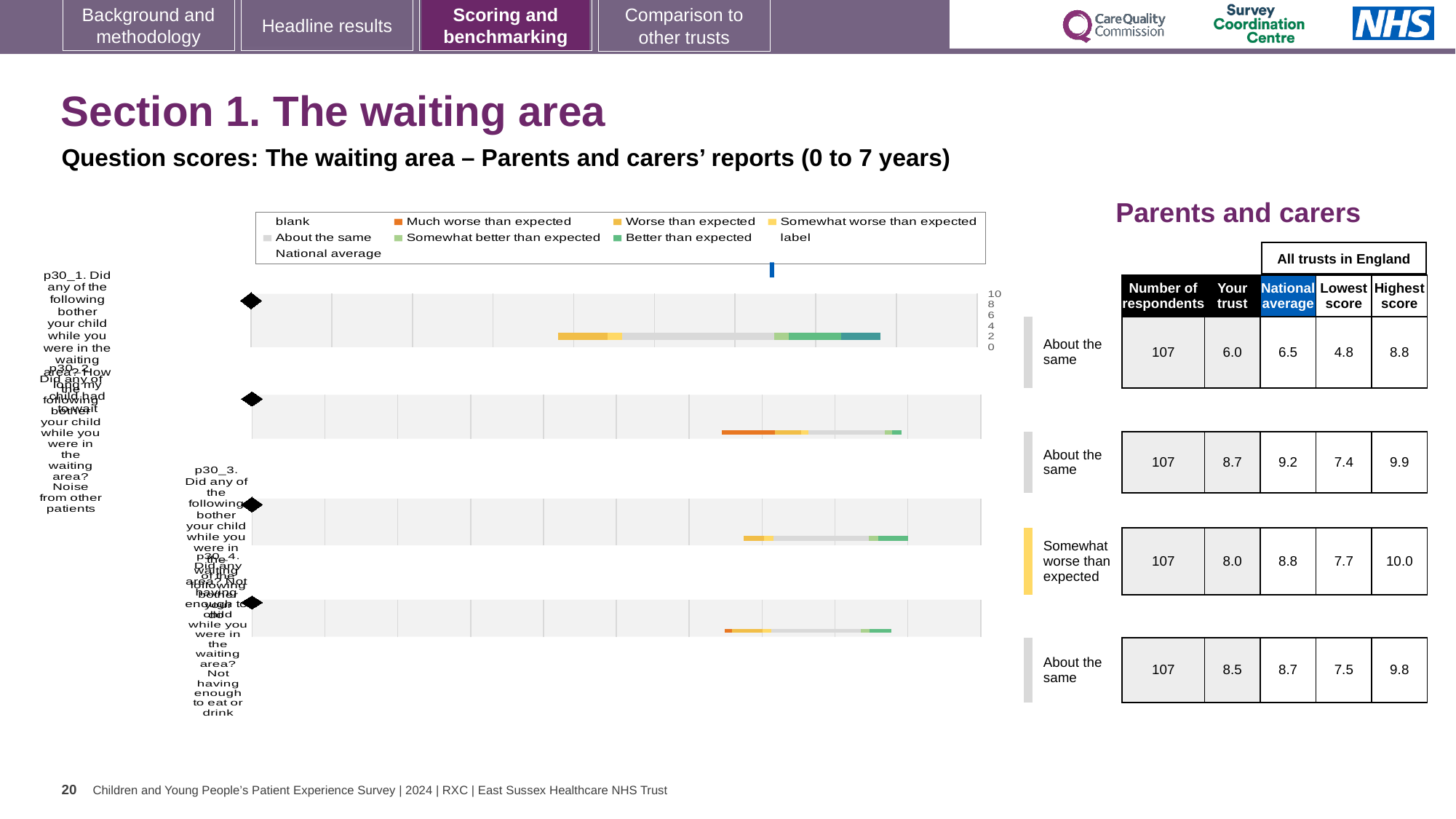
How many entries does the chart legend list? 9 What is the difference between the national average and the 'Your trust' score for the first question (p30_1)? 0.5 In the table beside the chart, what is the national average for the second question (p30_2)? 9.2 In the table beside the chart, what is the highest score across all trusts in England for the third question (p30_3)? 10.0 For the fourth question (p30_4), is the 'Your trust' score or the national average larger? National average (8.7) What kind of chart is shown on the slide? bar chart Which legend entry is shown in orange? Much worse than expected Which benchmark category is assigned to the third question (p30_3)? Somewhat worse than expected How many question bars (p30_1 to p30_4) are plotted in the chart? 4 In the table beside the chart, which question has the highest 'Your trust' score? p30_2 (second row), 8.7 In the table beside the chart, which question has the lowest 'Your trust' score? p30_1 (first row), 6.0 In the table beside the chart, what is the 'Your trust' score for the first question (p30_1)? 6.0